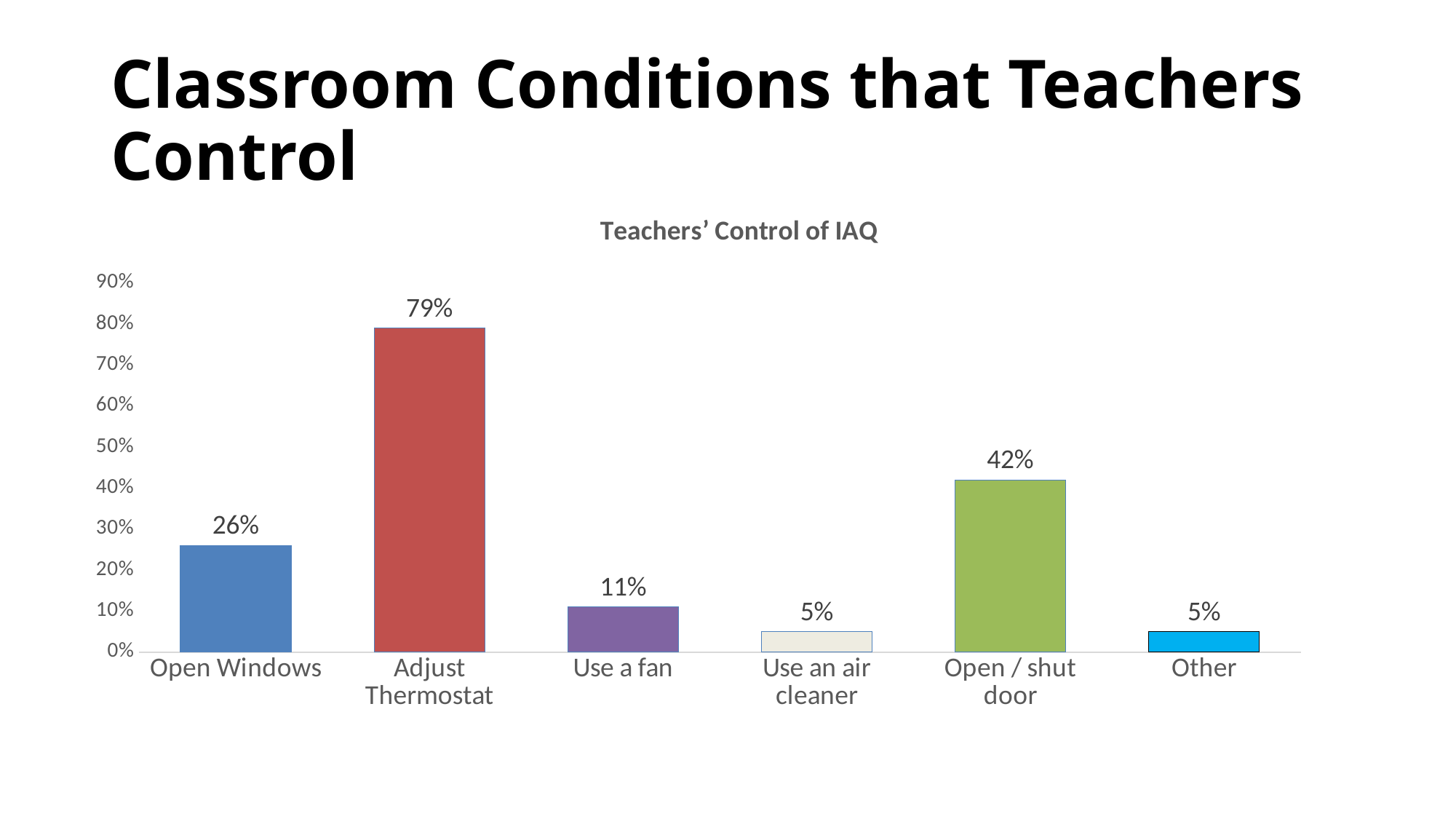
What is the value for Use a fan? 11% What kind of chart is shown on the slide? bar chart What is the difference between the values for Adjust Thermostat and Open / shut door? 37% What is the value for Adjust Thermostat? 79% What is the value for Open / shut door? 42% What is the difference between the values for Open Windows and Use a fan? 15% What is the title of the chart? Teachers' Control of IAQ What is the value for Open Windows? 26% Which is larger, the value for Open Windows or the value for Open / shut door? Open / shut door Is the value for Adjust Thermostat greater or less than 70%? greater Which category has the highest value? Adjust Thermostat How many categories are shown on the chart? 6